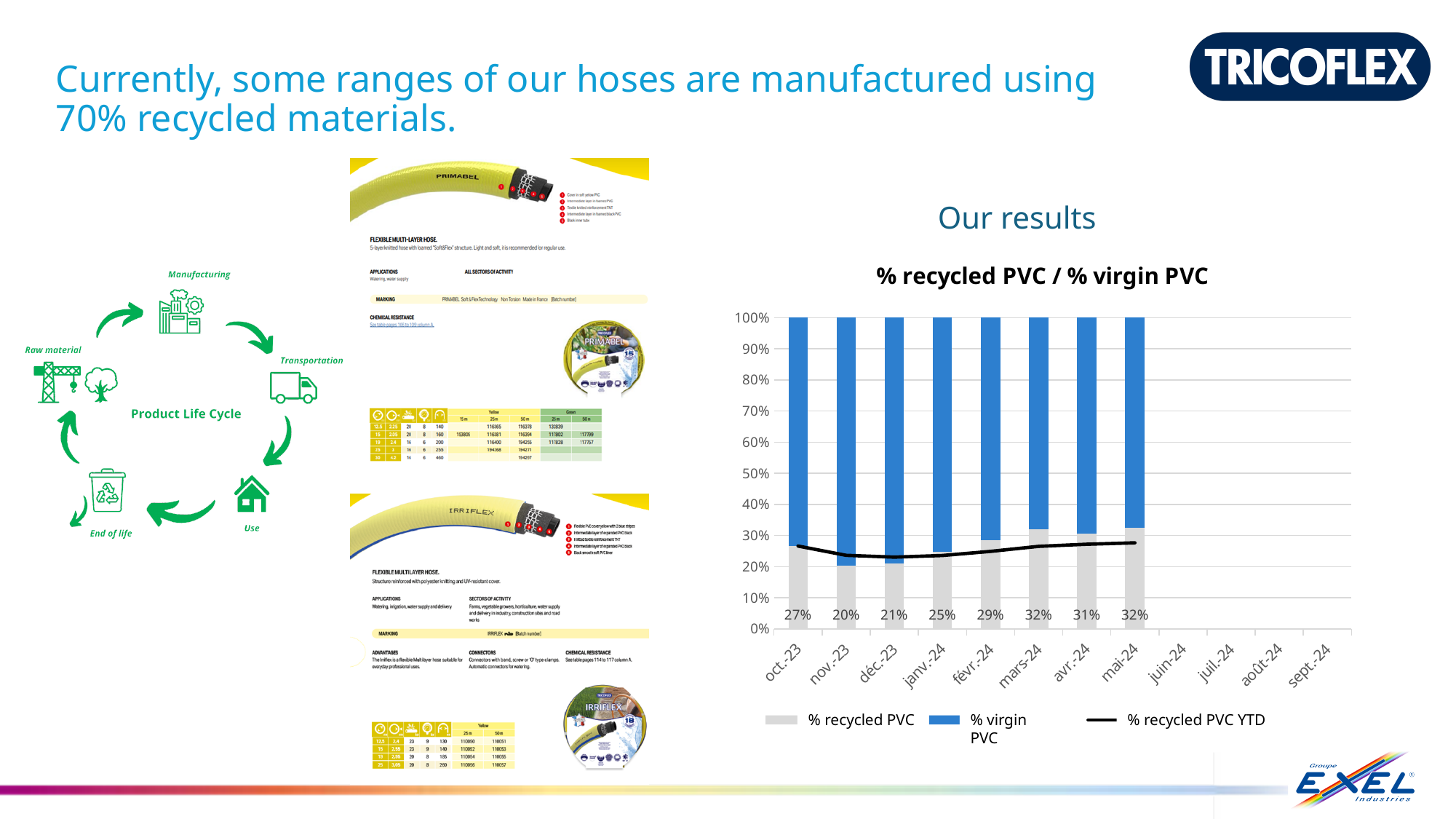
What is the title of the chart? % recycled PVC / % virgin PVC What is the % recycled PVC value for mars-24? 32% What is the % recycled PVC value for oct.-23? 27% How many series does the chart legend list? 3 Which month has a higher % recycled PVC, janv.-24 or févr.-24? févr.-24 Which month has the lowest % recycled PVC? nov.-23 What is the % recycled PVC value for avr.-24? 31% What kind of chart is used to show % recycled PVC and % virgin PVC? Stacked bar chart with a line How many months have % recycled PVC data labels shown on the chart? 8 What is the difference in % recycled PVC between mars-24 and nov.-23? 12% Is the % virgin PVC value for nov.-23 greater or less than 70%? greater Does the % recycled PVC rise or fall from nov.-23 to mars-24? Rise